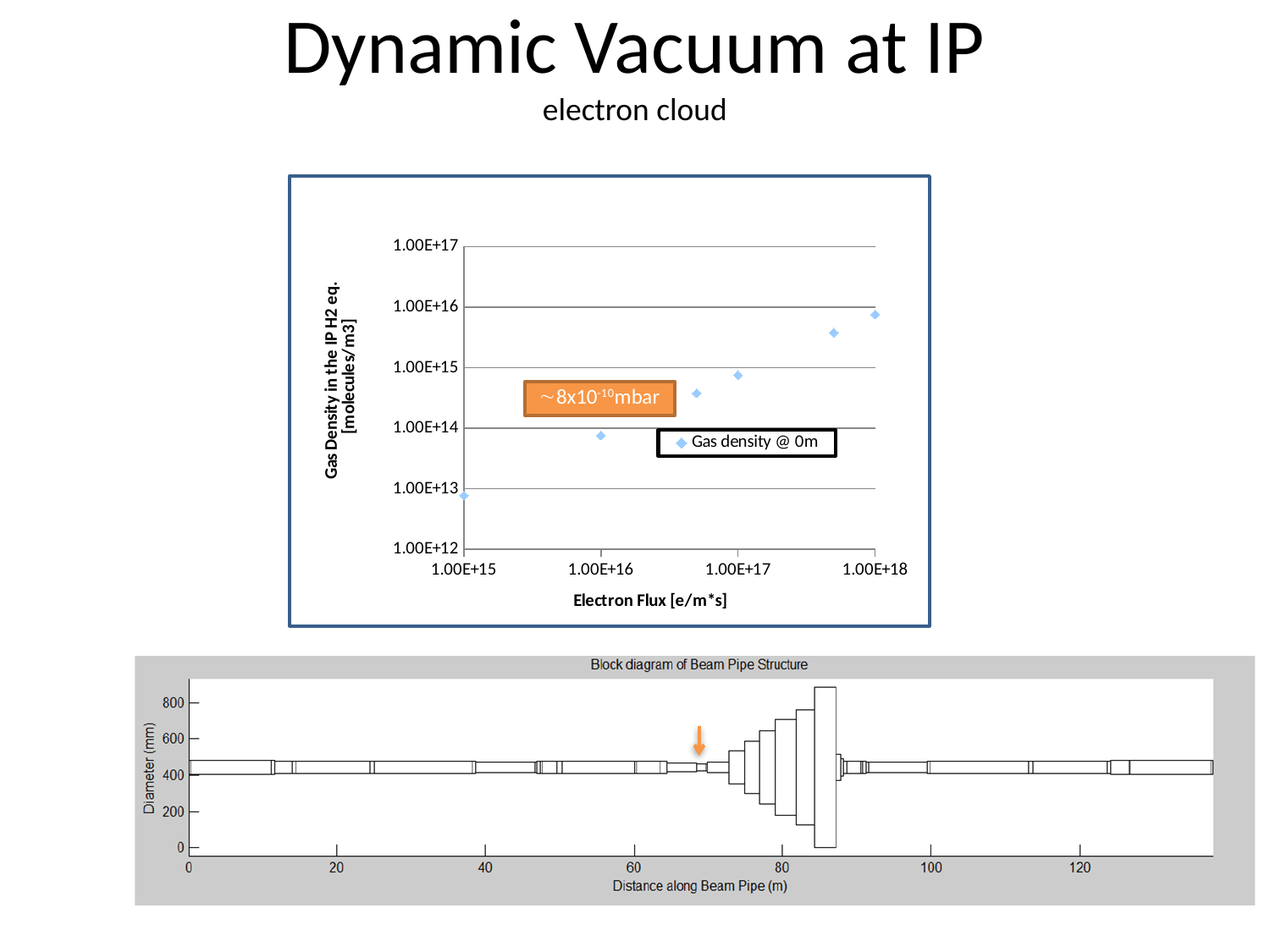
In the gas density chart, which has the larger gas density: the point at 1.00E+17 or the point at 1.00E+16 electron flux? 1.00E+17 In the gas density chart, is the gas density at an electron flux of 1.00E+18 greater or less than 1.00E+16? less In the gas density chart, is the gas density at an electron flux of 1.00E+17 greater or less than 1.00E+15? less What is the x-axis title of the gas density chart? Electron Flux [e/m*s] What is the legend entry in the gas density chart? Gas density @ 0m In the gas density chart, at which electron flux is the gas density lowest? 1.00E+15 How many series does the legend of the gas density chart list? 1 In the gas density chart, does the gas density rise or fall as electron flux increases? rises In the gas density chart, is the gas density at an electron flux of 1.00E+16 greater or less than 1.00E+14? less What kind of chart is shown in the blue-bordered box? scatter chart In the gas density chart, at which electron flux is the gas density highest? 1.00E+18 How many data points are plotted in the gas density chart? 6